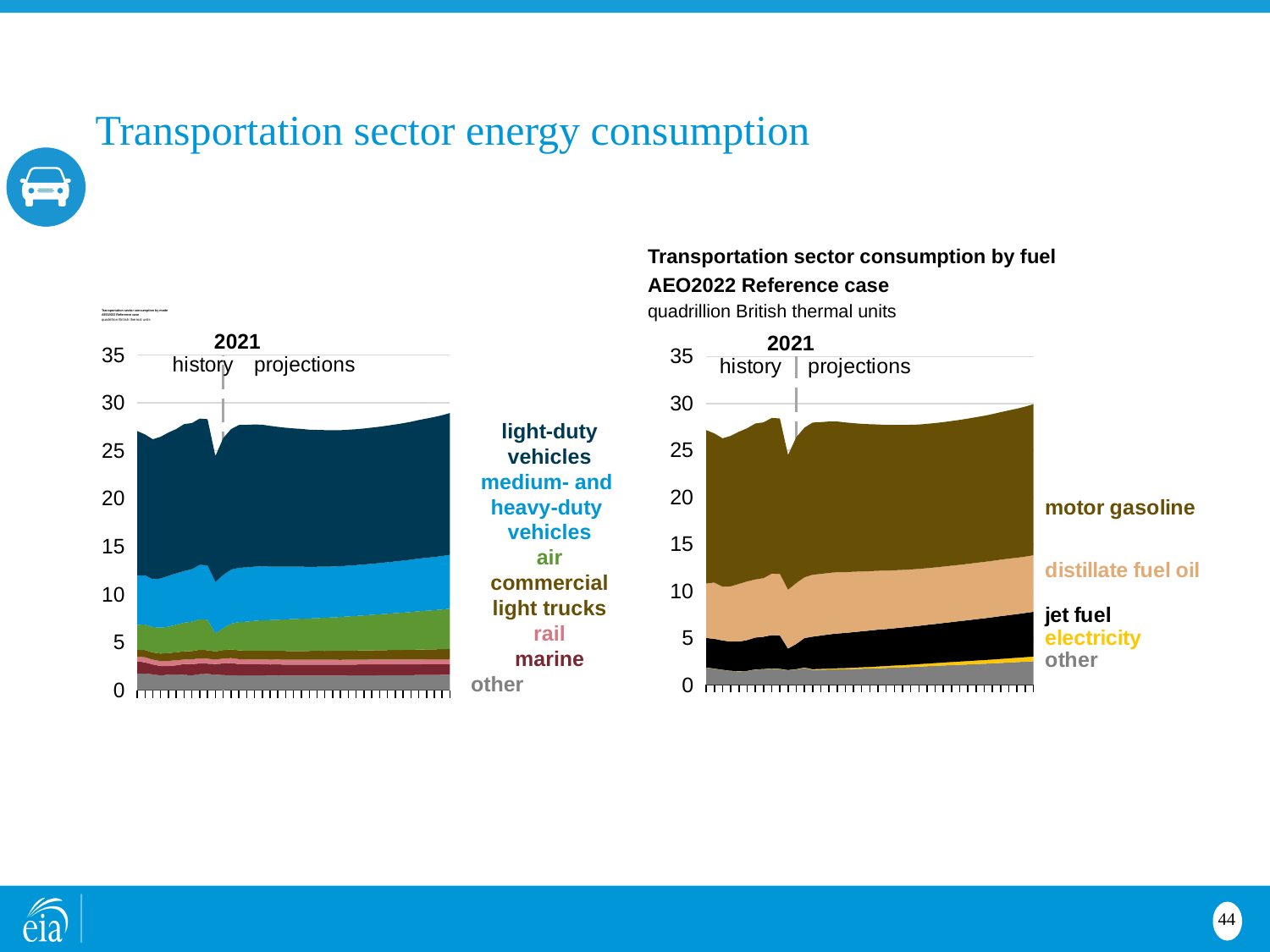
In the right-hand chart, 'Transportation sector consumption by fuel', which year separates history from projections? 2021 In the right-hand chart, 'Transportation sector consumption by fuel', is consumption of motor gasoline larger or smaller than consumption of electricity? larger In the left-hand chart, which mode accounts for the largest share of transportation energy consumption? light-duty vehicles What kind of chart is the left-hand chart on the slide? stacked area chart What kind of chart is the right-hand chart, 'Transportation sector consumption by fuel'? stacked area chart How many series are labelled on the right-hand chart, 'Transportation sector consumption by fuel'? 5 How many series are labelled on the left-hand chart? 7 In the right-hand chart, 'Transportation sector consumption by fuel', is the total consumption at the end of the projection period greater or less than 20? greater What unit of measurement is used on the right-hand chart, 'Transportation sector consumption by fuel'? quadrillion British thermal units In the right-hand chart, 'Transportation sector consumption by fuel', which fuel accounts for the largest share of consumption? motor gasoline In the right-hand chart, 'Transportation sector consumption by fuel', is the total consumption at the start of the history period greater or less than 25? greater In the left-hand chart, is consumption by light-duty vehicles larger or smaller than consumption by rail? larger